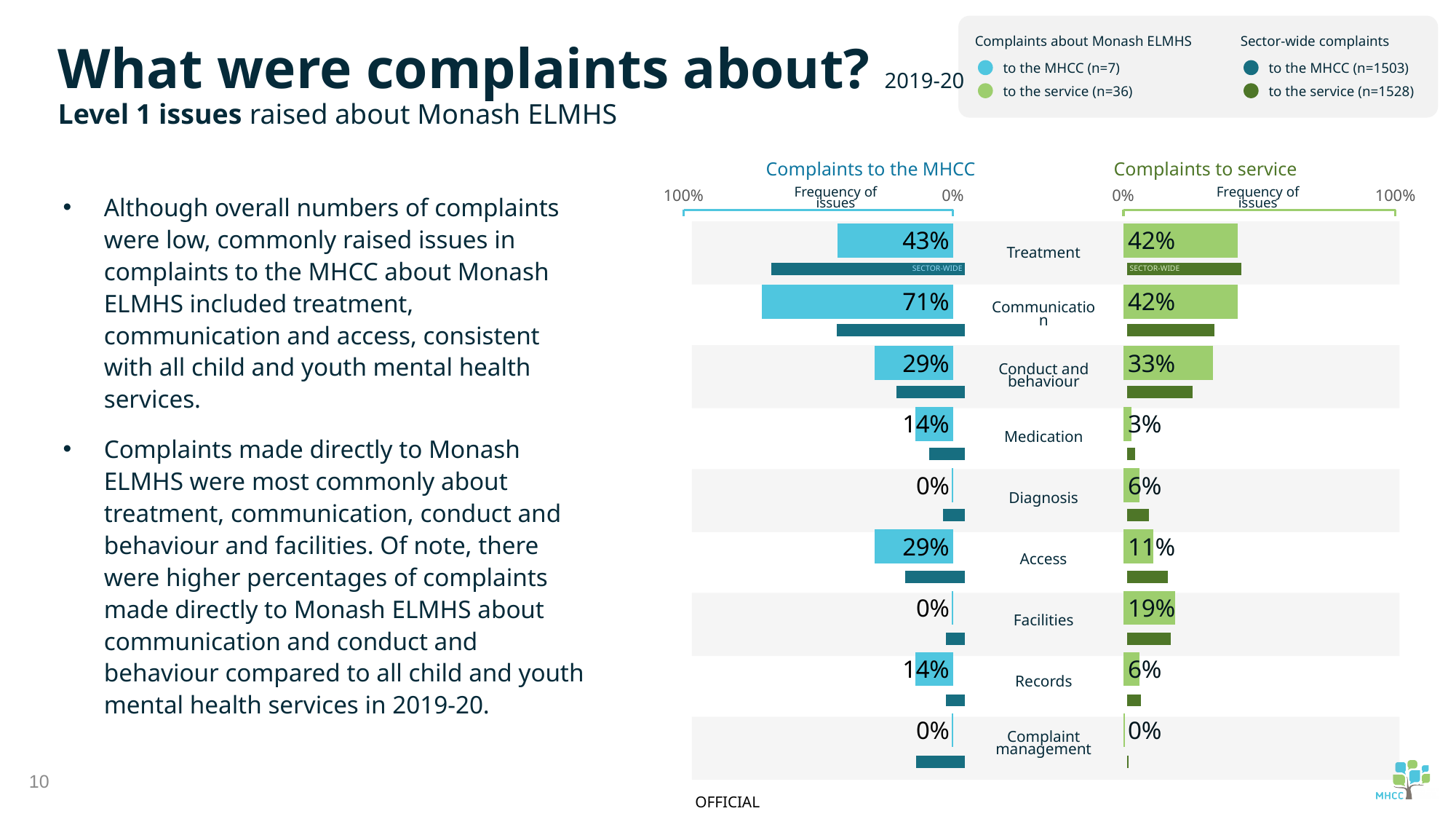
In the 'Complaints to service' chart, which category has the lowest labelled value? Complaint management According to the legend, how many complaints about Monash ELMHS were made to the service (n)? 36 What kind of chart is the 'Complaints to service' chart? Bar chart In the 'Complaints to the MHCC' chart, how many categories have a value of 0%? 3 Which is larger: the value for Access in the 'Complaints to the MHCC' chart or the value for Access in the 'Complaints to service' chart? Complaints to the MHCC How many categories are shown in the 'Complaints to the MHCC' chart? 9 In the 'Complaints to the MHCC' chart, what is the value for Communication? 71% In the 'Complaints to the MHCC' chart, what is the difference between the values for Communication and Treatment? 28% In the 'Complaints to service' chart, is the value for Medication greater or less than the value for Diagnosis? less In the 'Complaints to the MHCC' chart, which category has the highest labelled value? Communication In the 'Complaints to service' chart, what is the value for Facilities? 19% In the 'Complaints to service' chart, what is the difference between the values for Treatment and Conduct and behaviour? 9%